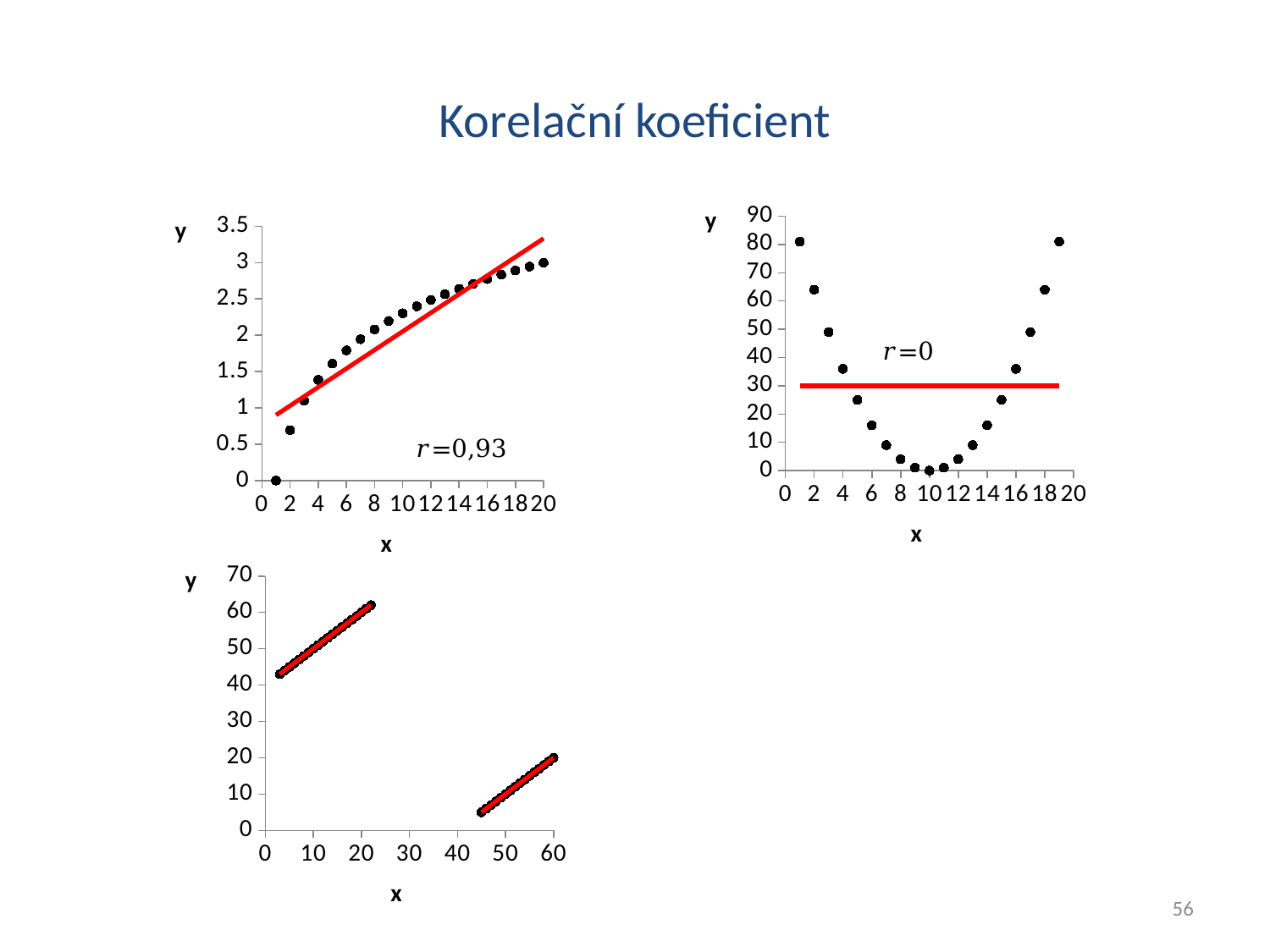
In the top-left chart, is the y value at x=2 greater or less than 1? less In the top-right chart, which is larger: the y value at x=4 or the y value at x=8? x=4 In the top-right chart, at which x value is y lowest? 10 In the top-left chart, is the y value at x=16 greater or less than 2.5? greater What correlation coefficient is printed on the top-left chart? r=0,93 In the top-right chart, is the y value at x=6 greater or less than 20? less In the top-left chart, do the y values rise or fall as x increases? rise What kind of chart is the top-left chart on the slide? scatter chart What correlation coefficient is printed on the top-right chart? r=0